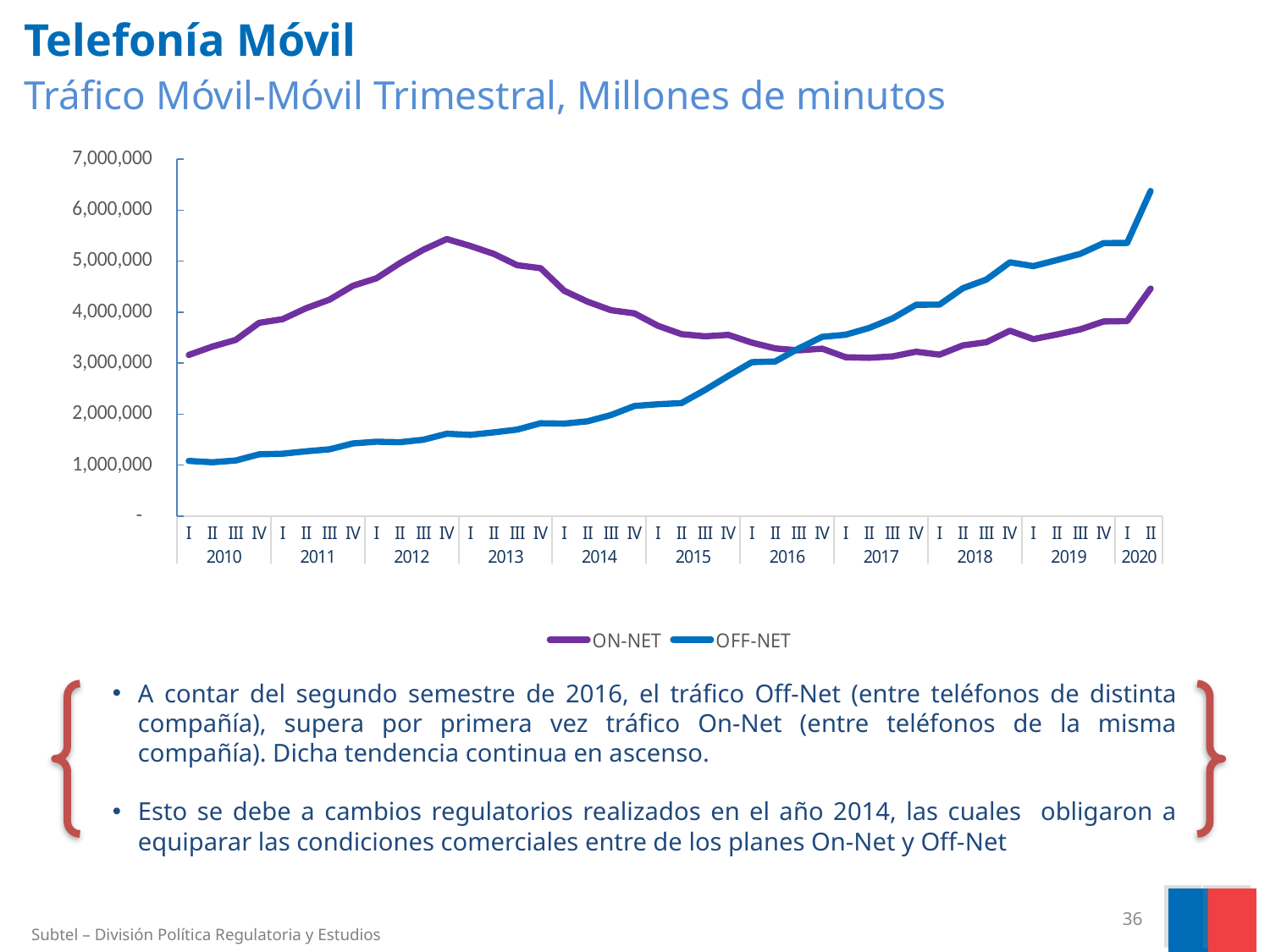
What are the two series named in the legend? ON-NET and OFF-NET Is the ON-NET value for quarter IV of 2012 greater or less than 5,000,000? greater In quarter II of 2020, which series has the larger value, ON-NET or OFF-NET? OFF-NET Is the ON-NET value for quarter I of 2017 greater or less than 4,000,000? less Is the OFF-NET value for quarter II of 2020 greater or less than 6,000,000? greater In quarter IV of 2012, which series has the larger value, ON-NET or OFF-NET? ON-NET In which quarter does the OFF-NET series reach its highest value? II 2020 Does the OFF-NET series generally rise or fall from 2010 to 2020? Rise How many series does the legend list? 2 What kind of chart is shown on the slide? Line chart What is the title of the chart? Tráfico Móvil-Móvil Trimestral, Millones de minutos